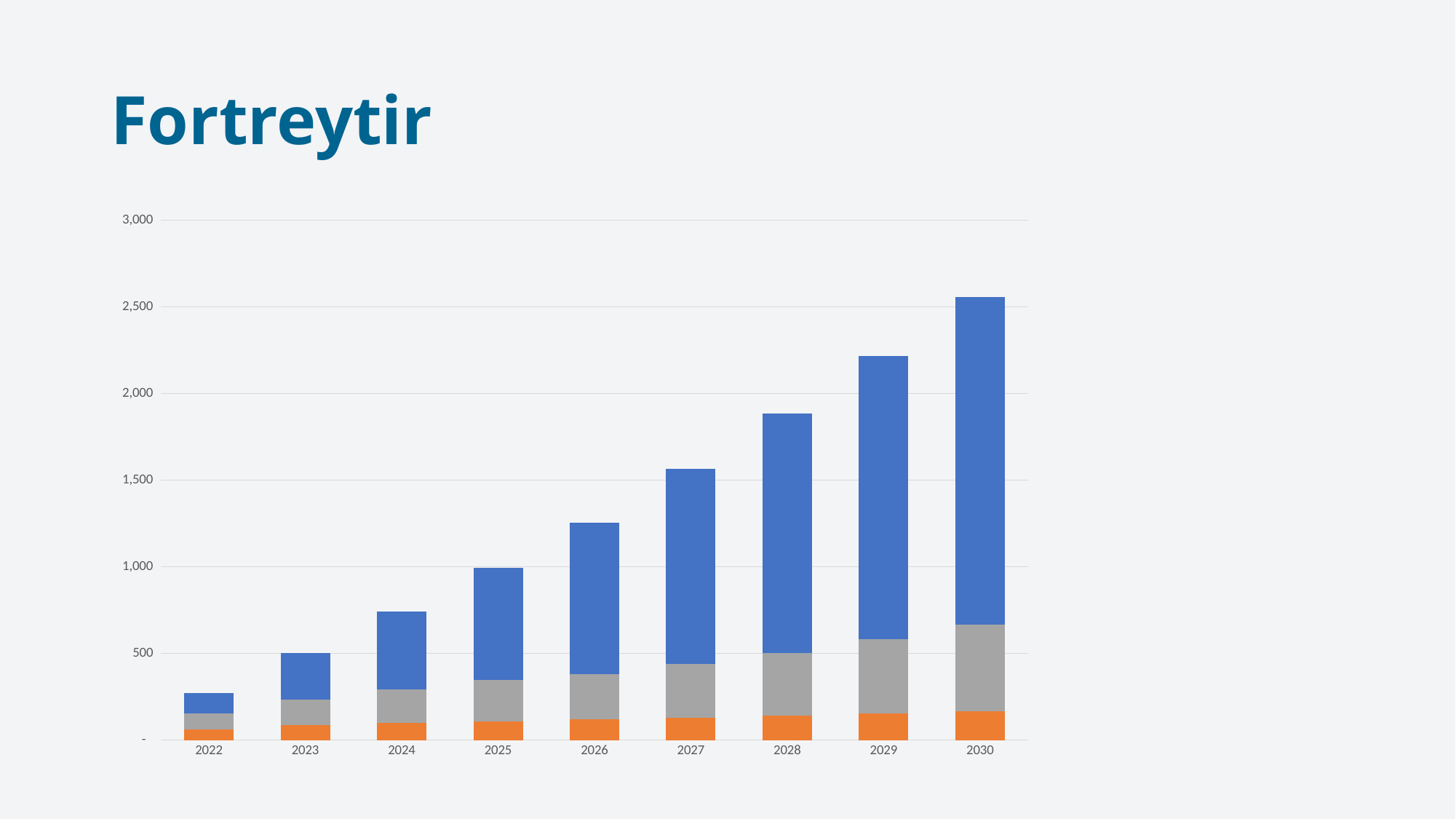
Which year has the shortest stacked bar? 2022 How many years are shown on the x axis of the chart? 9 Is the total value for 2024 greater or less than 500? greater Is the total value for 2029 greater or less than 2,000? greater Do the bar totals rise or fall from 2022 to 2030? rise Is the total value for 2022 greater or less than 500? less Which year has the larger total, 2025 or 2027? 2027 What kind of chart is shown on the slide? stacked bar chart Which year has the tallest stacked bar? 2030 What is the title of the slide? Fortreytir